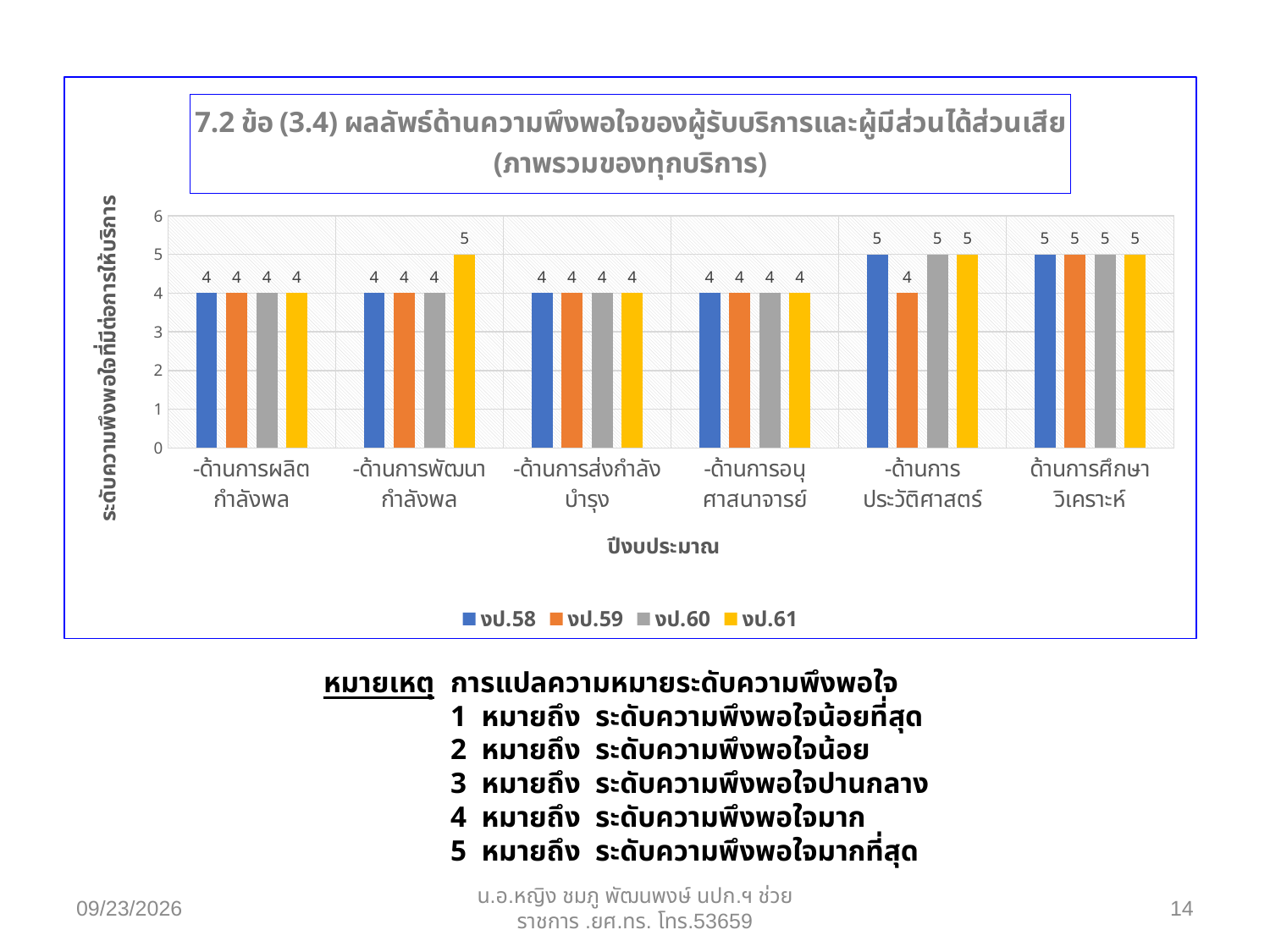
What is the value for งป.60 in the category ด้านการส่งกำลังบำรุง? 4 What is the difference between the งป.61 value and the งป.58 value in the category ด้านการพัฒนากำลังพล? 1 How many series does the legend list? 4 Which is larger in the category ด้านการประวัติศาสตร์: the value for งป.58 or the value for งป.59? งป.58 What is the value for งป.58 in the category ด้านการศึกษาวิเคราะห์? 5 Which series has the lowest value in the category ด้านการประวัติศาสตร์? งป.59 What is the value for งป.61 in the category ด้านการพัฒนากำลังพล? 5 What is the value for งป.59 in the category ด้านการประวัติศาสตร์? 4 Which series has the highest value in the category ด้านการพัฒนากำลังพล? งป.61 What kind of chart is shown on the slide? bar chart How many categories are shown on the x axis? 6 What is the label of the x axis? ปีงบประมาณ